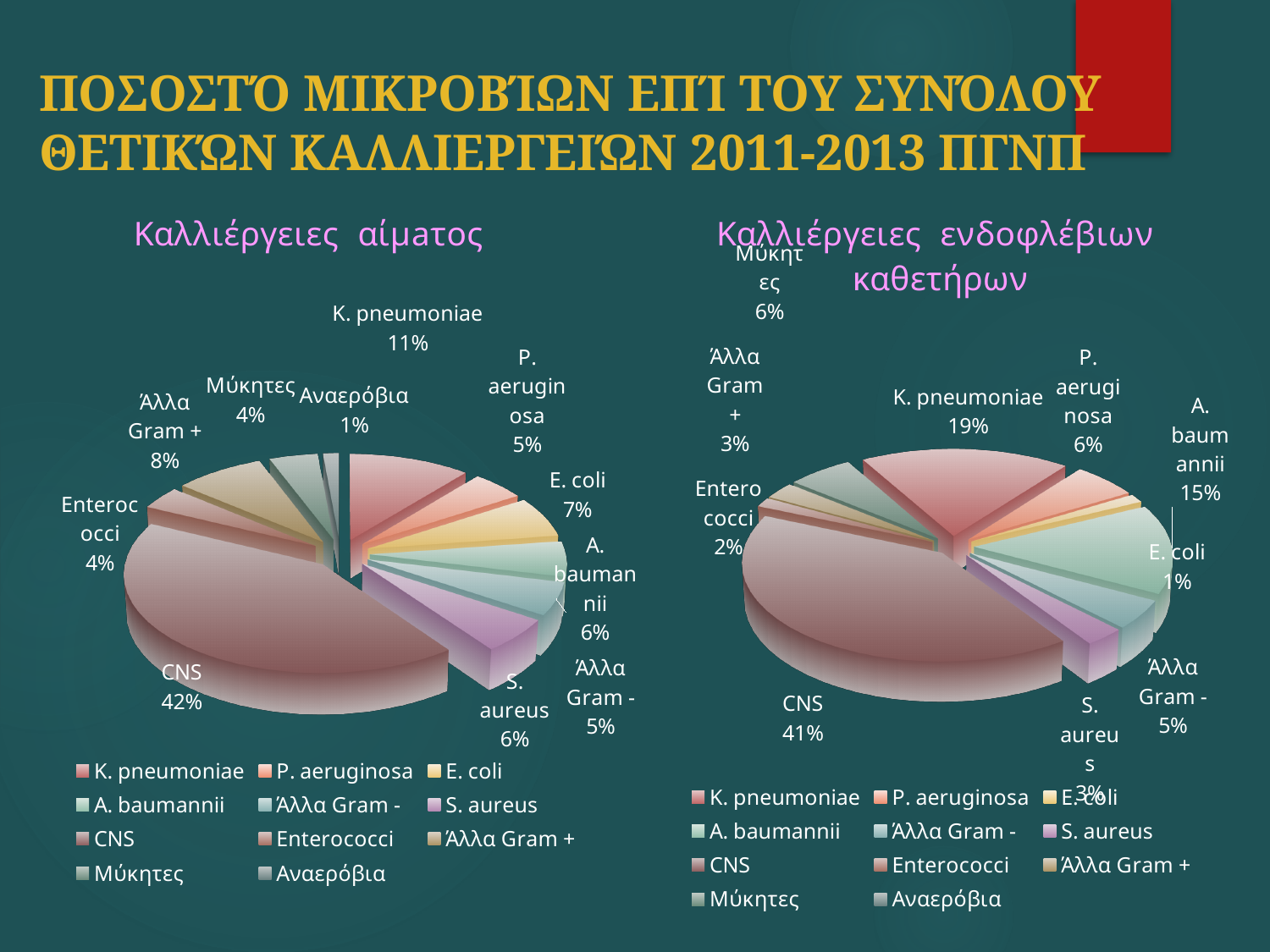
In the left pie chart (Καλλιέργειες αίματος), what percentage is shown for K. pneumoniae? 11% In the left pie chart (Καλλιέργειες αίματος), what is the difference between the shares of CNS and K. pneumoniae? 31% In the right pie chart (Καλλιέργειες ενδοφλέβιων καθετήρων), which is larger, the share of Μύκητες or the share of E. coli? Μύκητες What type of chart is used for Καλλιέργειες αίματος? Pie chart In the right pie chart (Καλλιέργειες ενδοφλέβιων καθετήρων), what is the difference between the shares of K. pneumoniae and A. baumannii? 4% In the left pie chart (Καλλιέργειες αίματος), which is larger, the share of E. coli or the share of P. aeruginosa? E. coli In the left pie chart (Καλλιέργειες αίματος), what percentage is shown for CNS? 42% How many entries does the legend of the left pie chart (Καλλιέργειες αίματος) list? 11 In the right pie chart (Καλλιέργειες ενδοφλέβιων καθετήρων), what percentage is shown for A. baumannii? 15% In the left pie chart (Καλλιέργειες αίματος), which category has the smallest share? Αναερόβια In the right pie chart (Καλλιέργειες ενδοφλέβιων καθετήρων), what percentage is shown for K. pneumoniae? 19% In the right pie chart (Καλλιέργειες ενδοφλέβιων καθετήρων), which category has the largest share? CNS